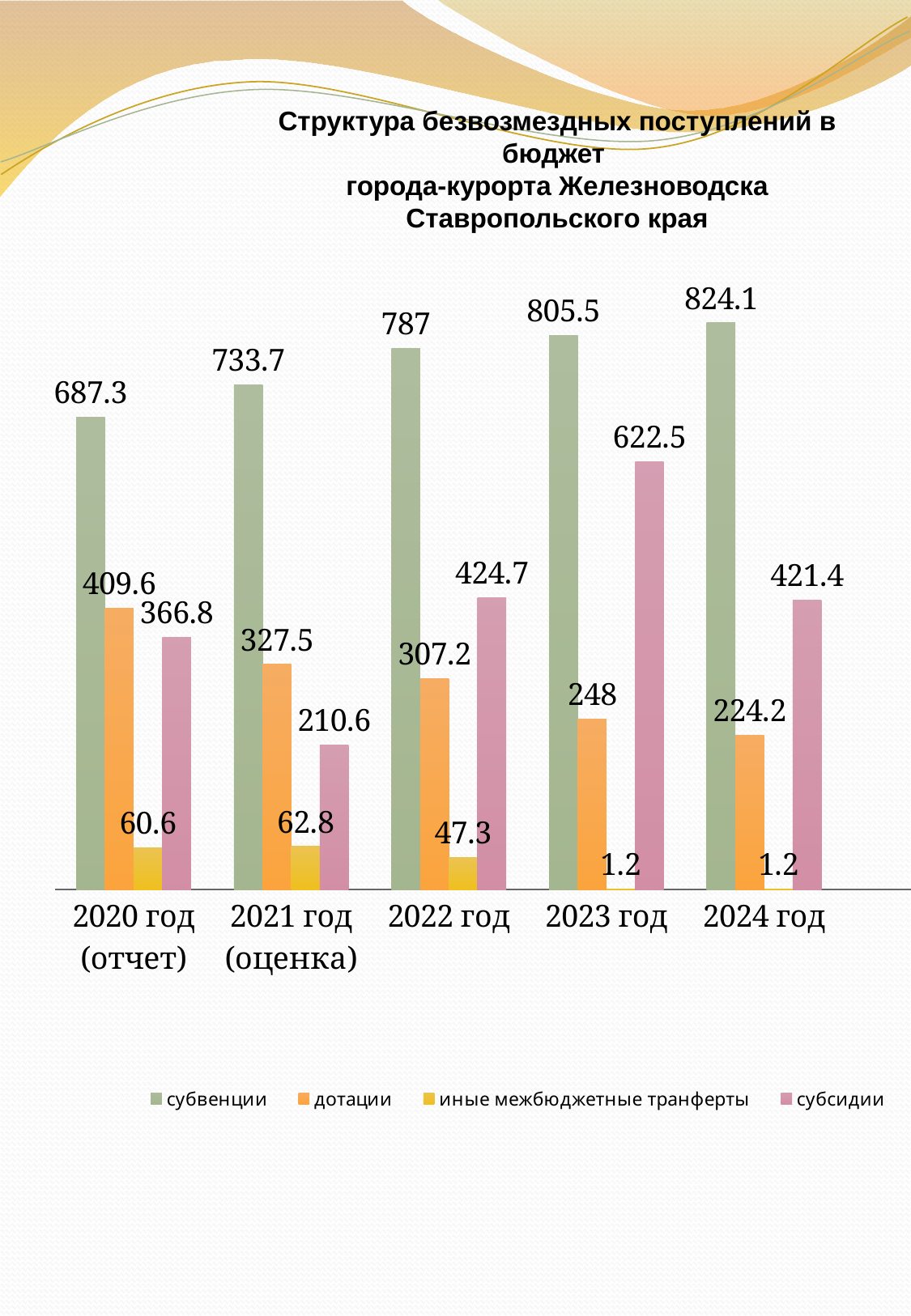
What is the value of иные межбюджетные транферты for 2024 год? 1.2 Which is larger in 2022 год: дотации or субсидии? субсидии How many series does the legend list? 4 What is the value of субвенции for 2022 год? 787 In which year is субсидии lowest? 2021 год (оценка) Do the values of дотации rise or fall from 2020 год to 2024 год? fall How many year categories are shown on the x axis? 5 What type of chart is shown on the slide? bar chart In which year is субвенции highest? 2024 год What is the value of дотации for 2020 год (отчет)? 409.6 What is the value of субсидии for 2023 год? 622.5 What is the difference between субвенции in 2024 год and 2020 год (отчет)? 136.8